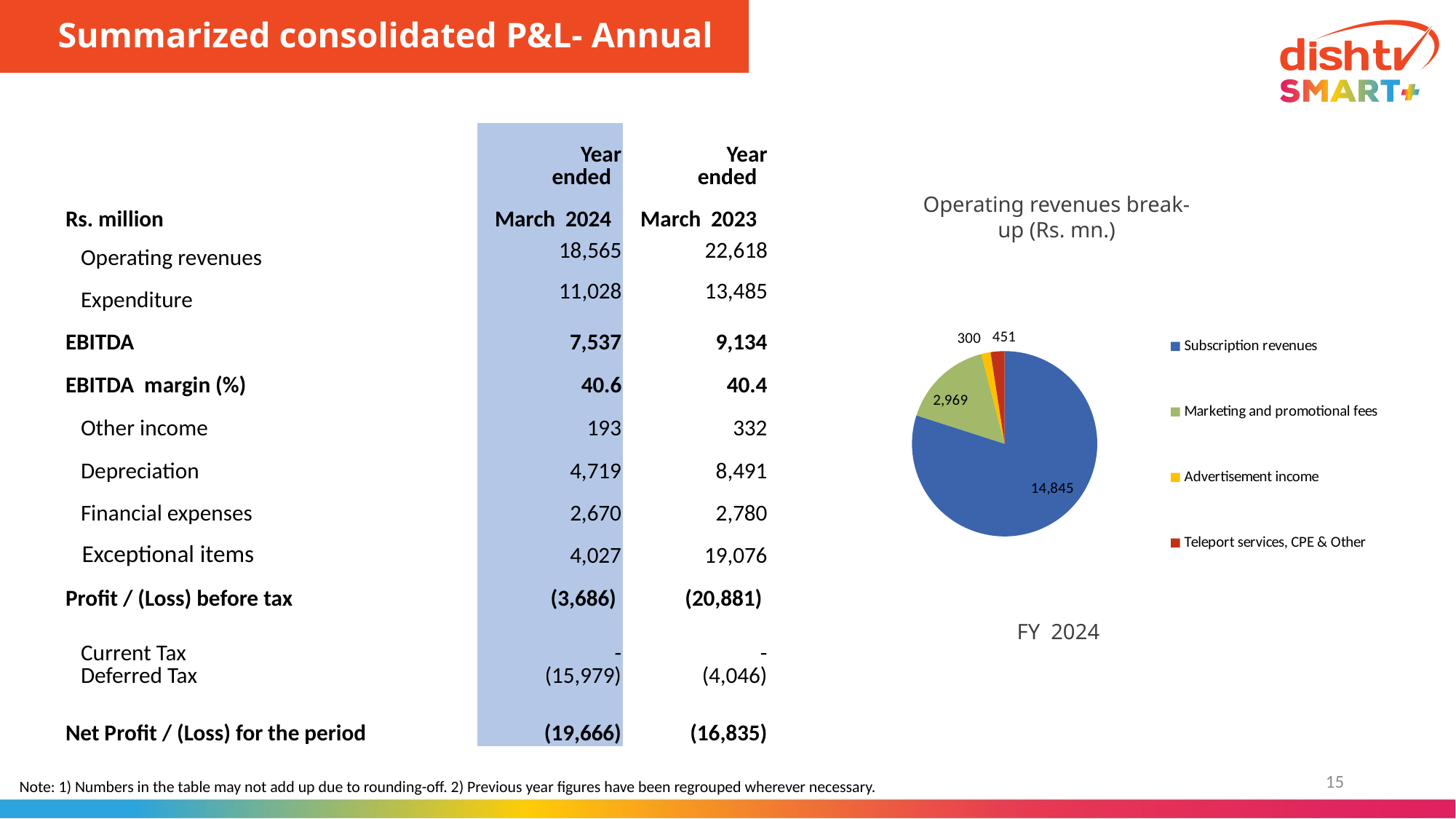
In the operating revenues break-up pie chart, what is the value for Advertisement income? 300 How many categories does the legend of the operating revenues break-up pie chart list? 4 In the operating revenues break-up pie chart, how much larger is Subscription revenues than Marketing and promotional fees? 11,876 Which fiscal year does the operating revenues break-up pie chart cover, according to the label below it? FY 2024 In the operating revenues break-up pie chart, what is the value for Subscription revenues? 14,845 In the operating revenues break-up pie chart, what is the value for Teleport services, CPE & Other? 451 What kind of chart is shown under the title "Operating revenues break-up (Rs. mn.)"? Pie chart What is the total of all slices in the operating revenues break-up pie chart? 18,565 In the operating revenues break-up pie chart, what is the value for Marketing and promotional fees? 2,969 In the operating revenues break-up pie chart, which is larger: Teleport services, CPE & Other or Advertisement income? Teleport services, CPE & Other Which category has the largest slice in the operating revenues break-up pie chart? Subscription revenues Which category has the smallest slice in the operating revenues break-up pie chart? Advertisement income